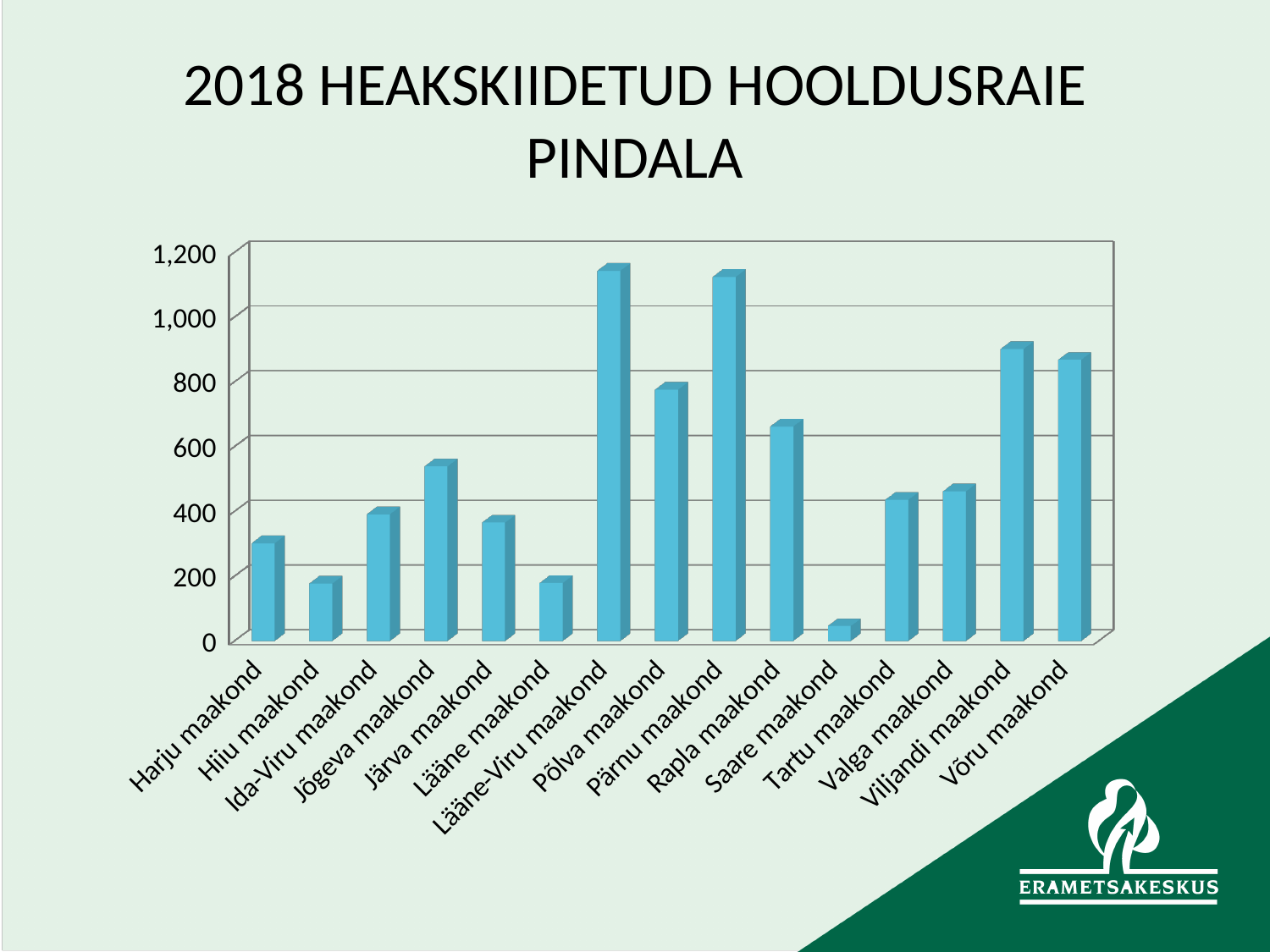
Is the value for Lääne-Viru maakond greater or less than 1,000? greater Is the value for Viljandi maakond greater or less than 800? greater Which has the larger value, Põlva maakond or Rapla maakond? Põlva maakond Which has the larger value, Viljandi maakond or Tartu maakond? Viljandi maakond How many counties (categories) are shown on the x axis of the chart? 15 Is the value for Jõgeva maakond greater or less than 400? greater What is the title of the chart on the slide? 2018 HEAKSKIIDETUD HOOLDUSRAIE PINDALA Which county has the lowest value in the chart? Saare maakond What kind of chart is shown on the slide? bar chart